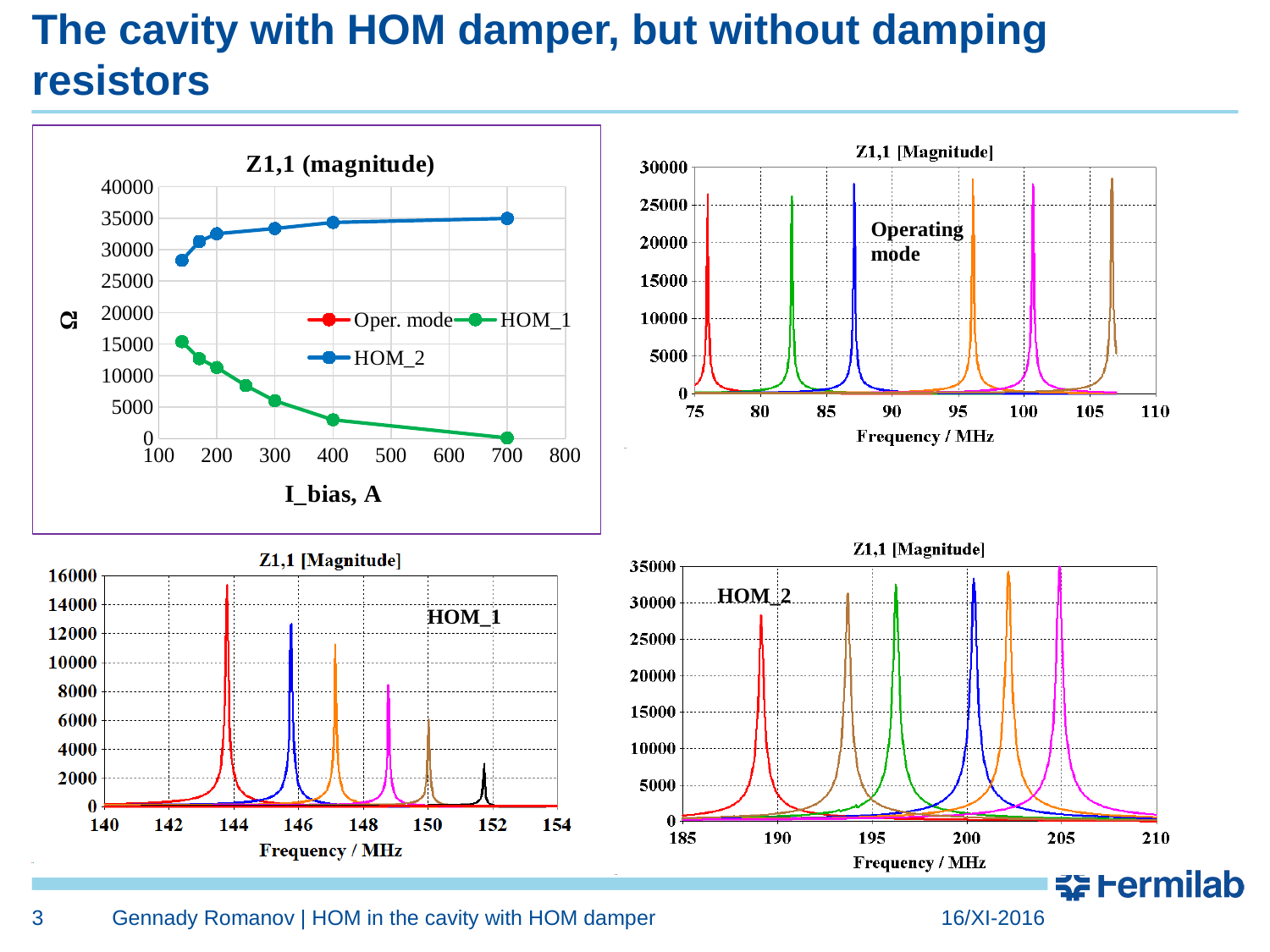
In the top-left chart titled 'Z1,1 (magnitude)', is the HOM_1 value at 700 A greater or less than 5000? less In the top-left chart titled 'Z1,1 (magnitude)', how many series does the legend list? 3 In the top-left chart titled 'Z1,1 (magnitude)', does the HOM_1 series rise or fall as I_bias increases? fall In the bottom-right chart labelled HOM_2, which peak is taller, the red one near 189 MHz or the magenta one near 205 MHz? the magenta one In the top-left chart titled 'Z1,1 (magnitude)', which series has the larger value at 400 A, HOM_1 or HOM_2? HOM_2 In the bottom-left chart labelled HOM_1, is the highest peak greater or less than 14000? greater What kind of chart is the top-left chart titled 'Z1,1 (magnitude)'? line chart In the bottom-left chart labelled HOM_1, how many resonance peaks are plotted? 6 In the top-left chart titled 'Z1,1 (magnitude)', is the HOM_2 value at 300 A greater or less than 30000? greater In the top-left chart titled 'Z1,1 (magnitude)', what are the names of the series in the legend? Oper. mode, HOM_1, HOM_2 In the top-left chart titled 'Z1,1 (magnitude)', does the HOM_2 series rise or fall as I_bias increases? rise In the top-left chart titled 'Z1,1 (magnitude)', what is the label of the x axis? I_bias, A